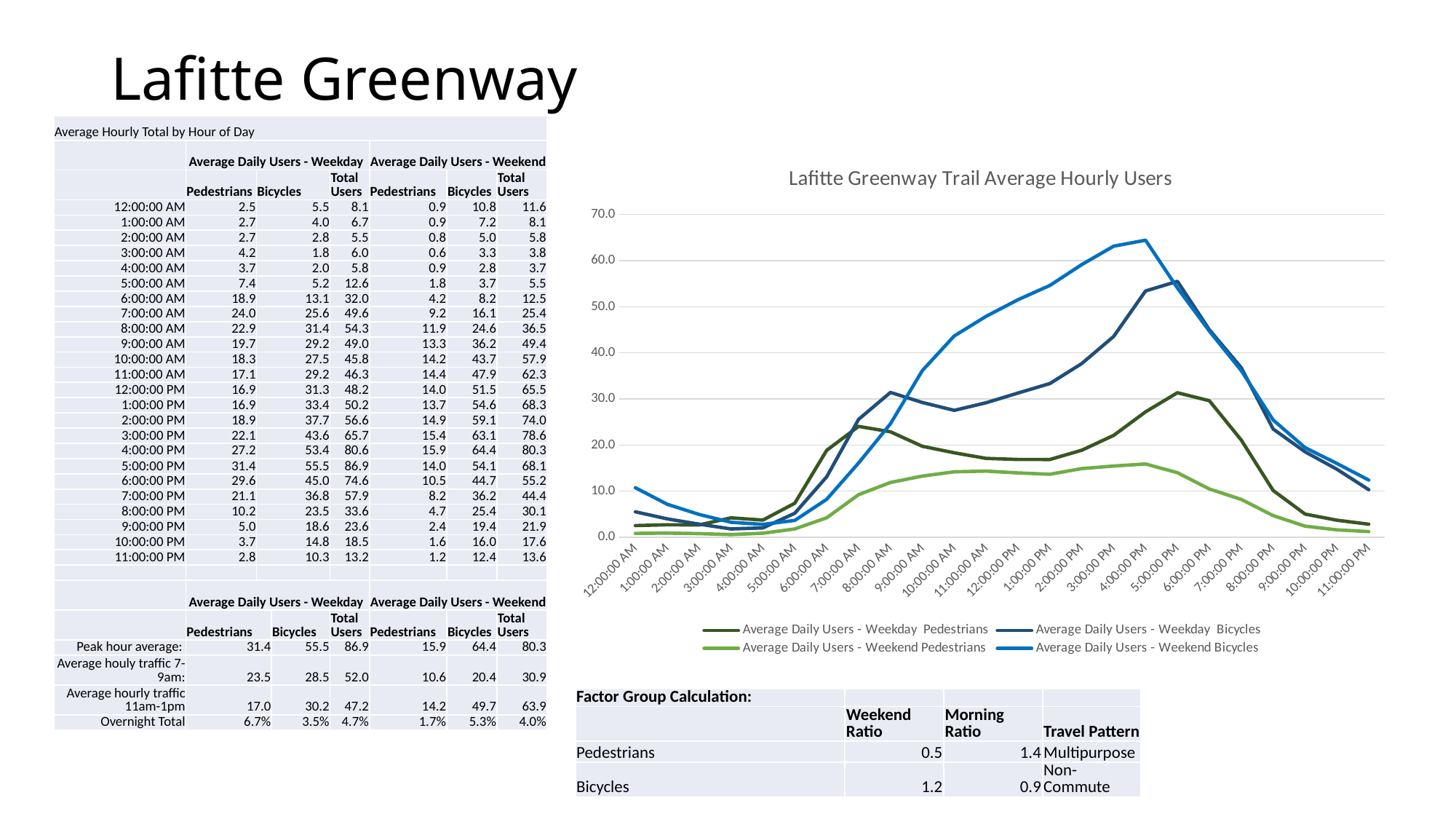
What type of chart is shown on the slide? line chart How many series does the legend of the chart list? 4 Is the value for Weekend Bicycles at 4:00:00 PM greater or less than 60? greater What is the Weekend Bicycles value at 4:00:00 PM? 64.4 Which series reaches the highest value on the chart? Average Daily Users - Weekend Bicycles Is the value for Weekday Bicycles at 5:00:00 PM greater or less than 50? greater What is the title of the chart? Lafitte Greenway Trail Average Hourly Users Does the Weekend Bicycles line rise or fall from 12:00:00 AM to 4:00:00 AM? fall How many hourly points are plotted along the x axis of the chart? 24 At 8:00:00 AM, which is larger: Weekday Bicycles or Weekend Bicycles? Weekday Bicycles What is the Weekday Pedestrians value at 5:00:00 PM? 31.4 What is the difference between the Weekend Bicycles value at 4:00:00 PM and the Weekday Bicycles value at 5:00:00 PM? 8.9